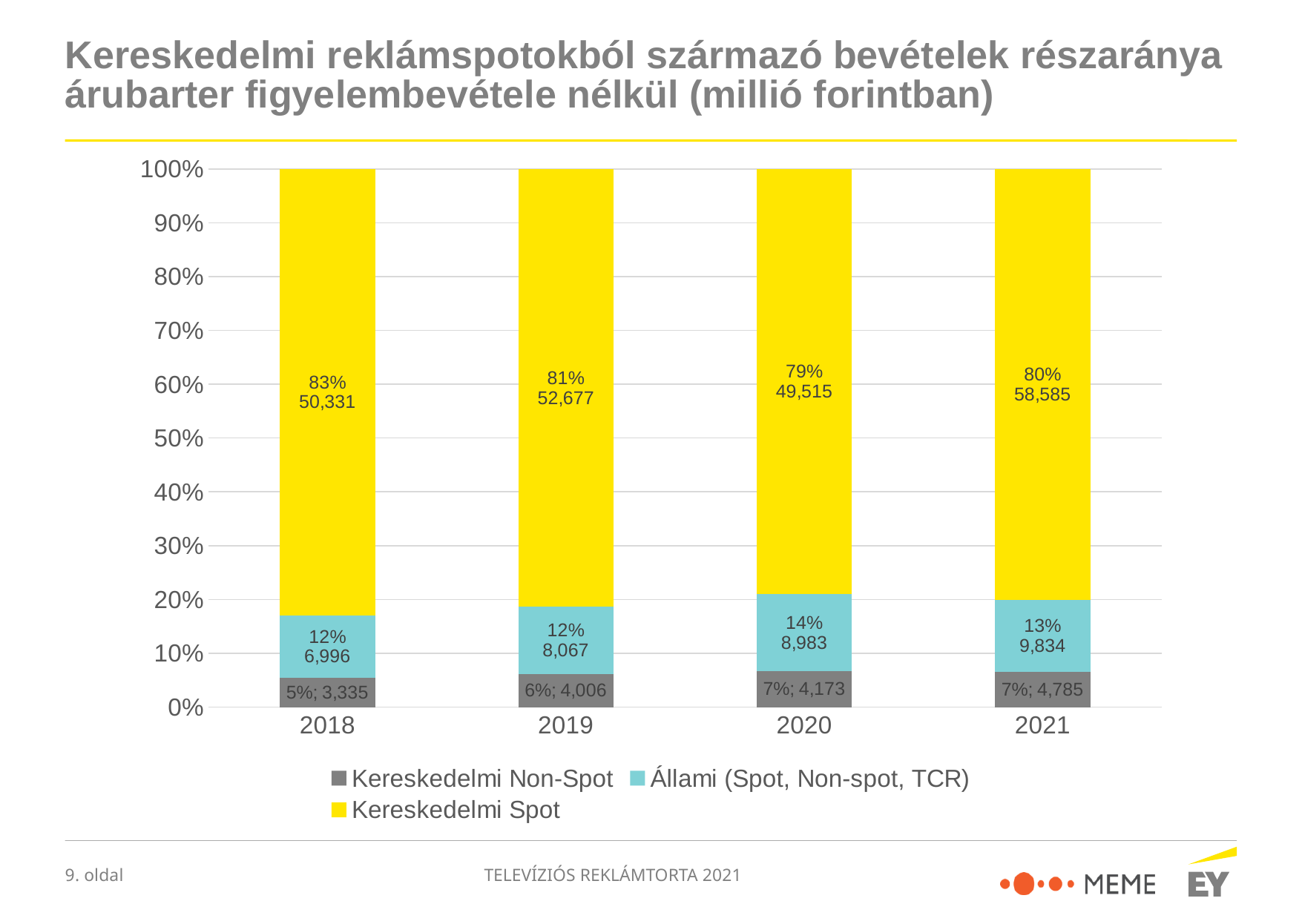
How many years are shown on the x axis? 4 What kind of chart is shown on the slide? Stacked bar chart What is the value for Kereskedelmi Spot in 2021? 58,585 In which year is the Állami (Spot, Non-spot, TCR) value the lowest? 2018 In which year is the Kereskedelmi Spot value the highest? 2021 What is the difference between the Kereskedelmi Spot values for 2021 and 2020? 9,070 How many series does the legend list? 3 What is the value for Állami (Spot, Non-spot, TCR) in 2020? 8,983 What is the value for Kereskedelmi Non-Spot in 2018? 3,335 What percentage share does Kereskedelmi Spot have in 2019? 81% Which is larger, the Kereskedelmi Non-Spot value for 2019 or for 2020? 2020 Do the Kereskedelmi Non-Spot values rise or fall from 2018 to 2021? Rise